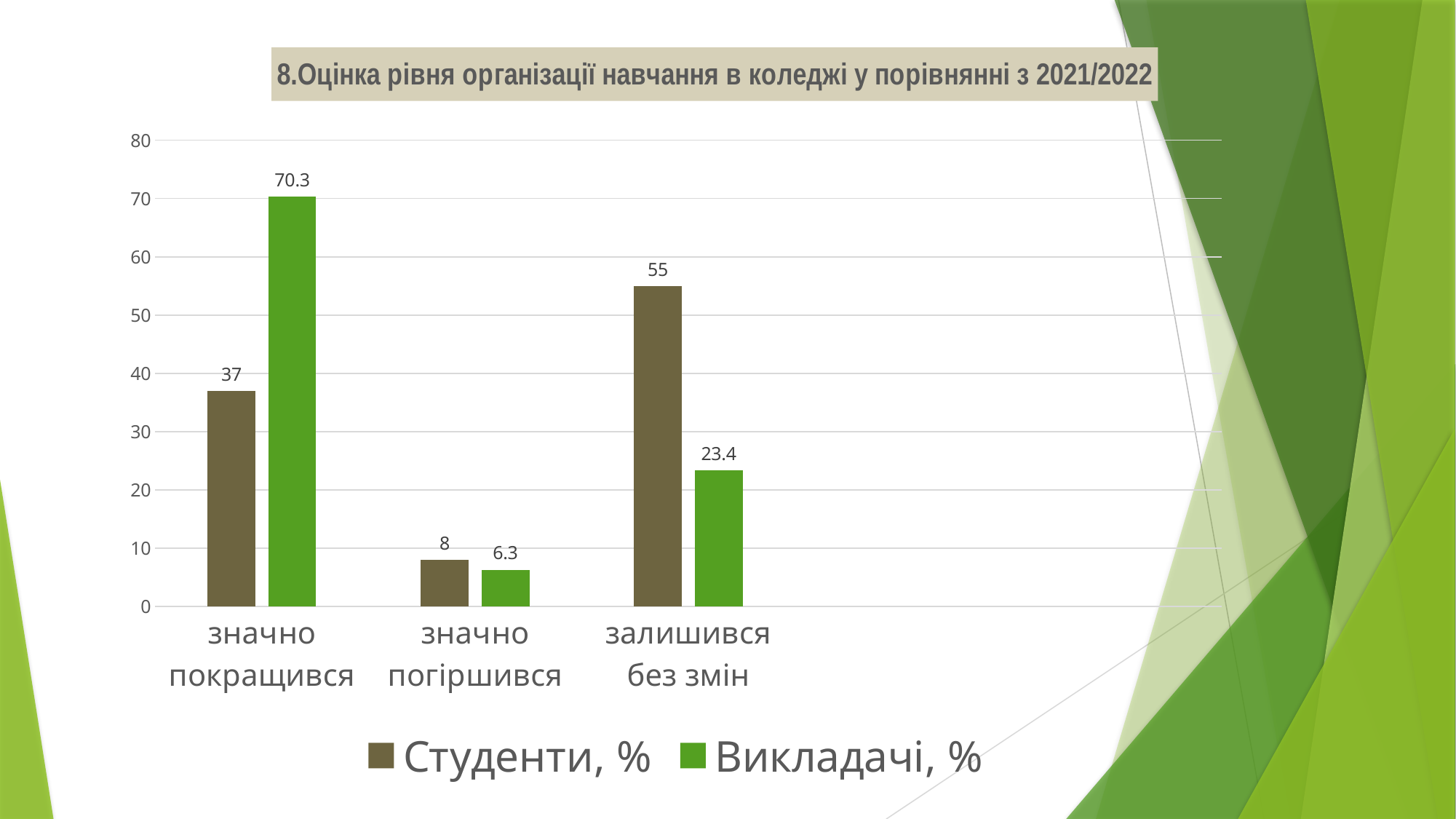
How many series does the legend list? 2 Which category has the lowest value for Студенти, %? значно погіршився What is the difference between Студенти, % and Викладачі, % in the category залишився без змін? 31.6 What value is shown for Студенти, % in the category значно погіршився? 8 Which category has the highest value for Викладачі, %? значно покращився What value is shown for Викладачі, % in the category значно покращився? 70.3 In the category значно покращився, which series has the larger value: Студенти, % or Викладачі, %? Викладачі, % How many categories are shown on the x axis? 3 What kind of chart is shown on the slide? bar chart What value is shown for Викладачі, % in the category залишився без змін? 23.4 What colour are the bars for the series Викладачі, %? green What value is shown for Студенти, % in the category значно покращився? 37